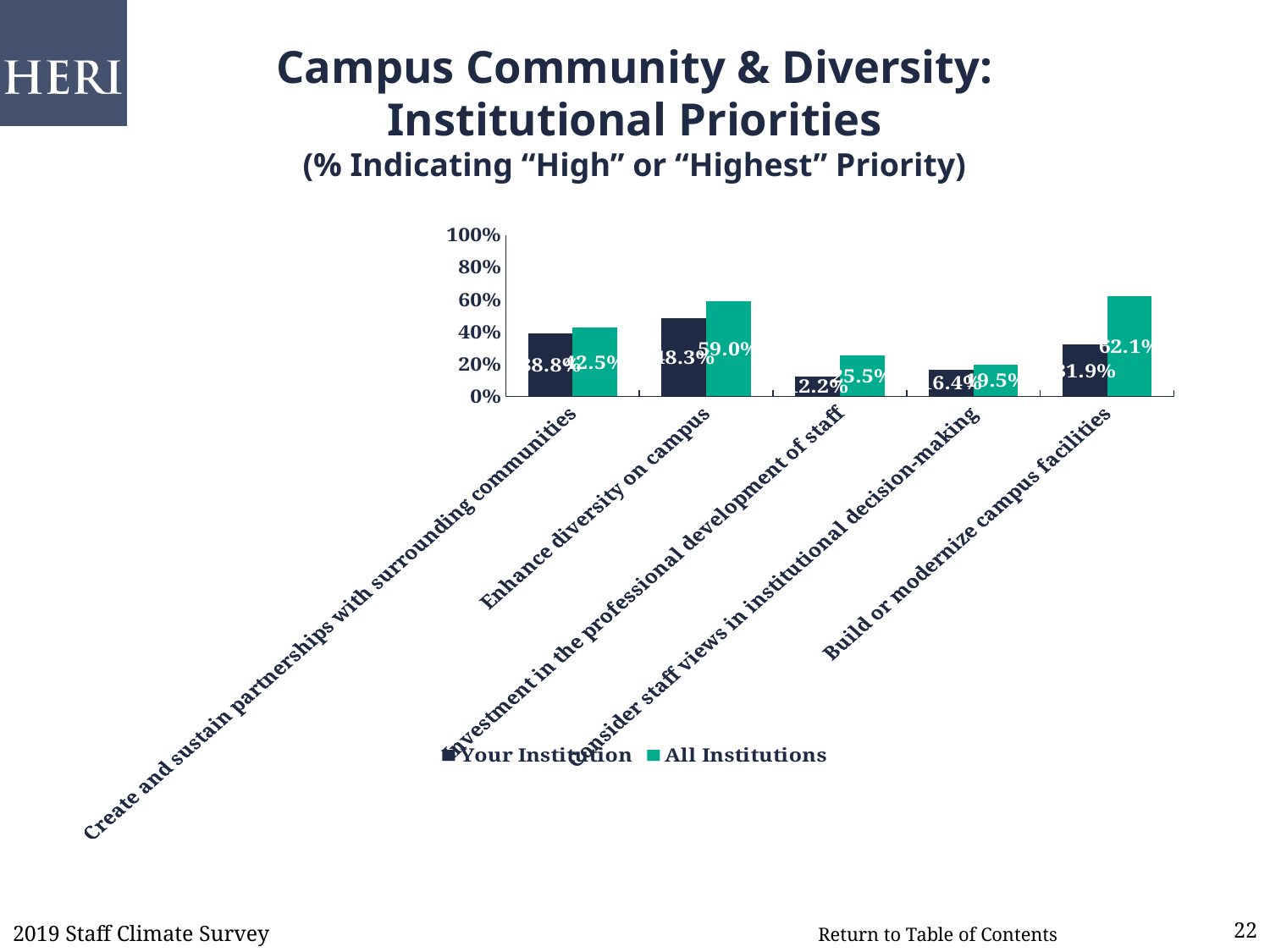
Which category has the highest All Institutions value? Build or modernize campus facilities What is the All Institutions value for "Build or modernize campus facilities"? 62.1% How many categories are shown on the x axis? 5 For "Build or modernize campus facilities", which is larger: Your Institution or All Institutions? All Institutions What is the difference between the All Institutions values for "Build or modernize campus facilities" and "Enhance diversity on campus"? 3.1 percentage points What are the two entries in the chart legend? Your Institution and All Institutions How many series does the legend list? 2 Which category has the highest Your Institution value? Enhance diversity on campus Is the Your Institution value for "Build or modernize campus facilities" greater or less than 40%? less What kind of chart is shown on the slide? bar chart Which category has the lowest All Institutions value? Consider staff views in institutional decision-making What is the All Institutions value for "Enhance diversity on campus"? 59.0%